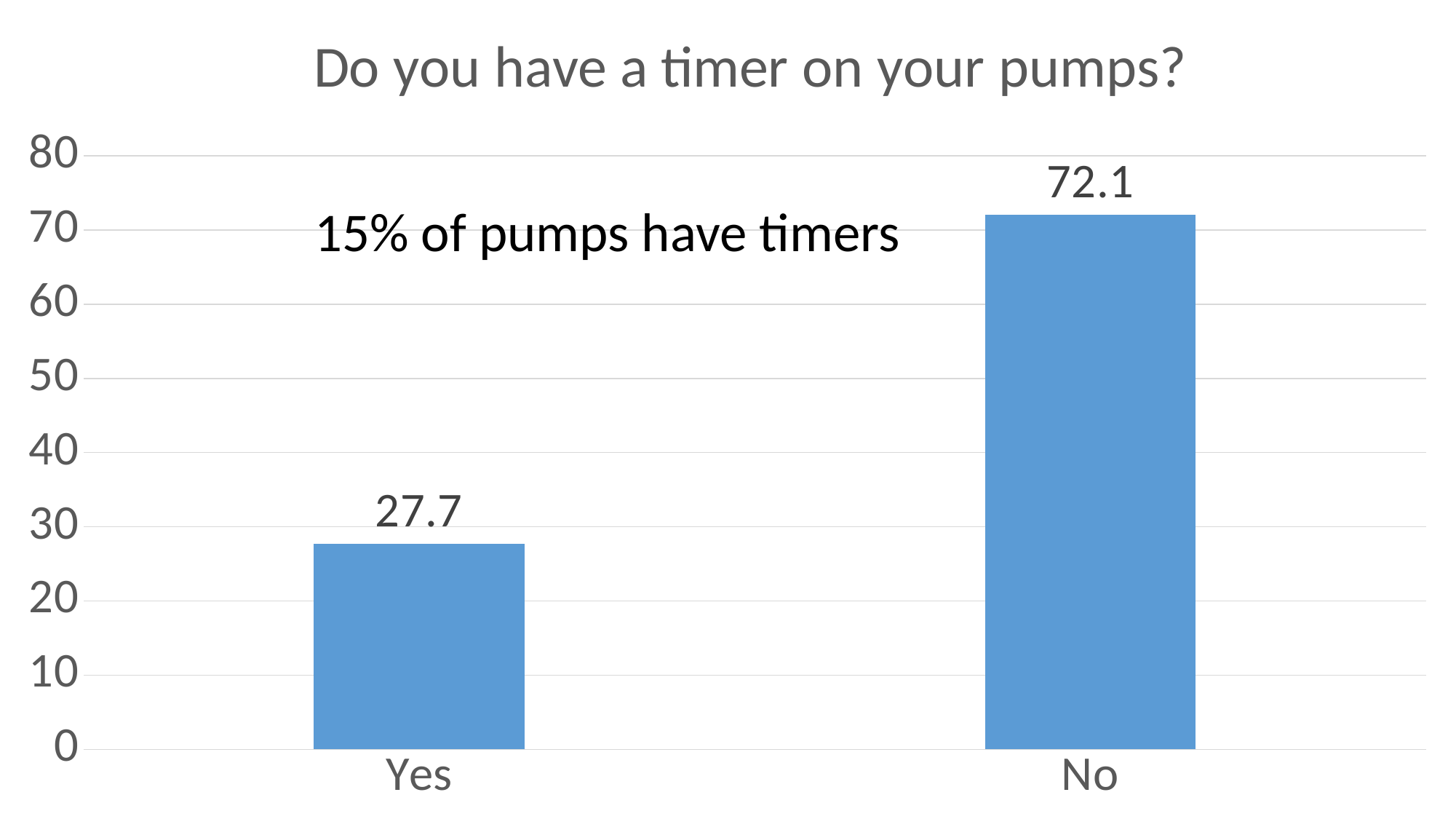
Which category has the lowest value? Yes What is the value for Yes? 27.7 What kind of chart is shown on the slide? bar chart What text annotation is printed inside the chart area? 15% of pumps have timers What is the title of the chart? Do you have a timer on your pumps? Is the value for Yes greater or less than 30? less Which category has the highest value? No What is the value for No? 72.1 How many categories are shown on the x axis? 2 Which is larger, the value for Yes or the value for No? No Is the value for No greater or less than 70? greater What is the difference between the values for No and Yes? 44.4